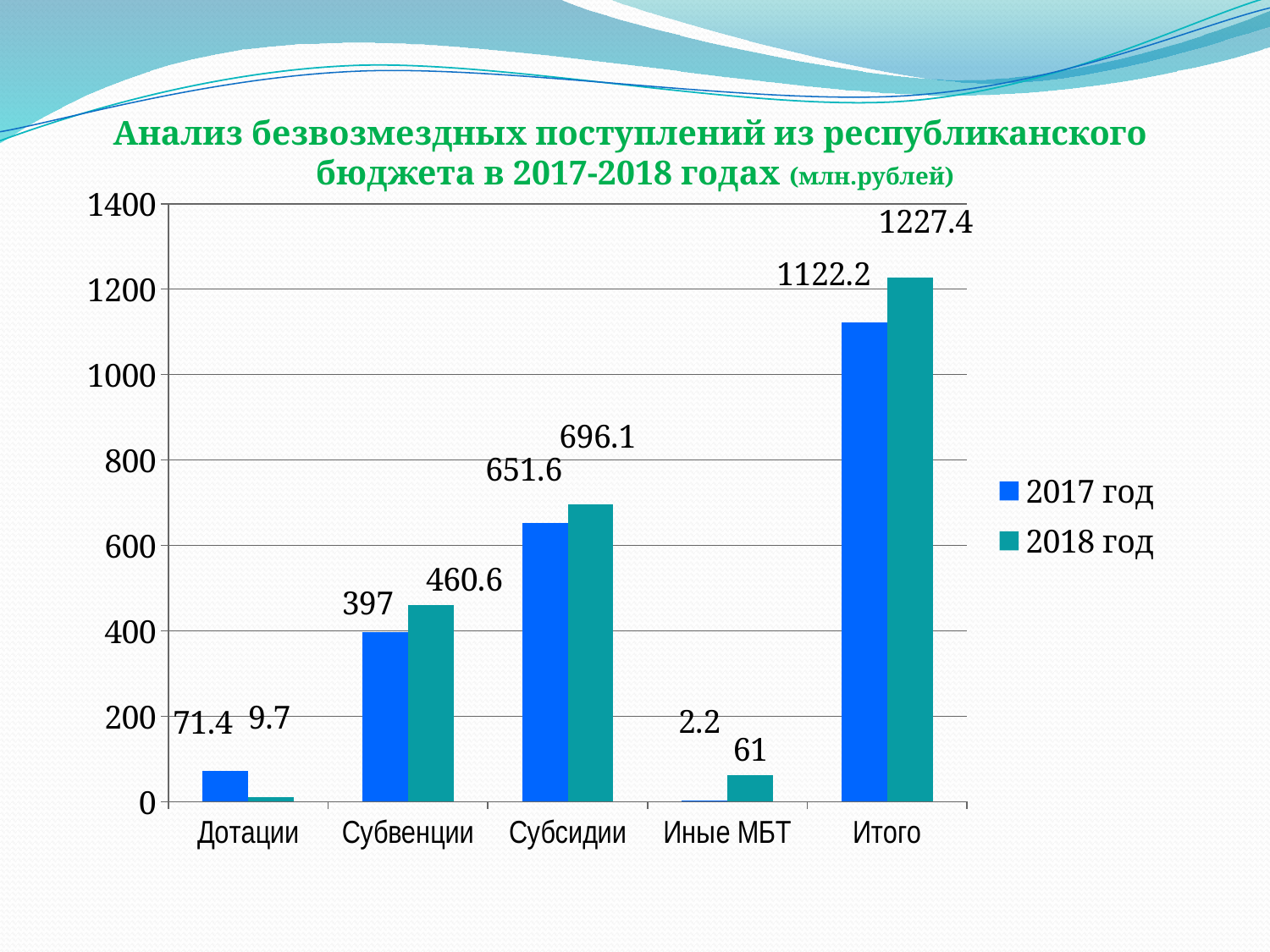
What is the value for Субвенции in the 2017 год series? 397 What is the value for Итого in the 2017 год series? 1122.2 How many categories are shown on the x axis? 5 Excluding Итого, which category has the highest value in the 2018 год series? Субсидии For Дотации, which series has the larger value, 2017 год or 2018 год? 2017 год Which category has the lowest value in the 2017 год series? Иные МБТ What is the value for Иные МБТ in the 2018 год series? 61 What is the difference between the 2018 год and 2017 год values for Итого? 105.2 How many series does the legend list? 2 What is the value for Дотации in the 2018 год series? 9.7 What kind of chart is shown on the slide? Bar chart What is the difference between the 2018 год and 2017 год values for Субсидии? 44.5